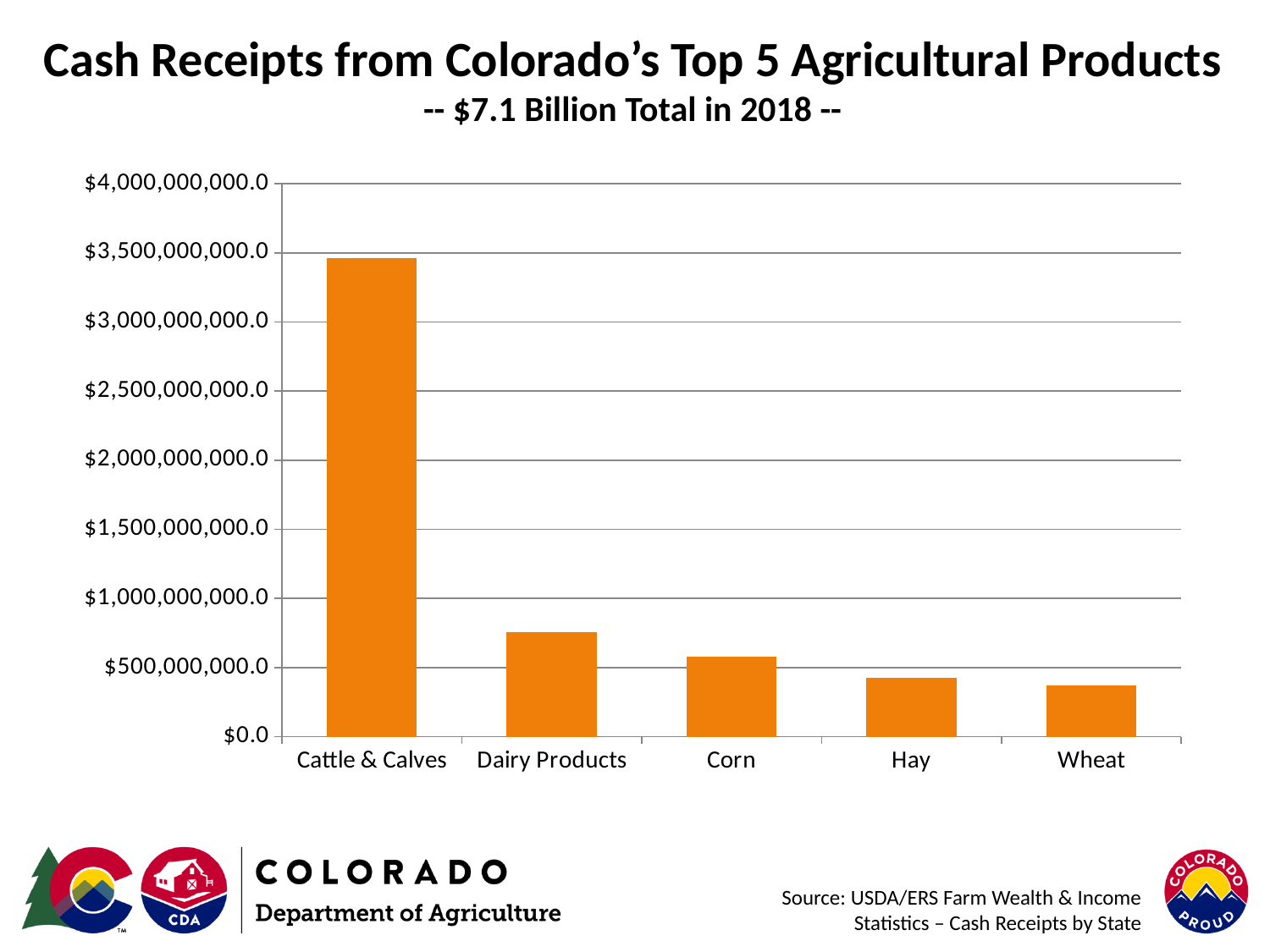
Which has higher cash receipts, Dairy Products or Corn? Dairy Products Is the value for Dairy Products greater or less than $500,000,000.0? greater Which product has the highest cash receipts? Cattle & Calves Do the values rise or fall moving from left to right across the categories? fall According to the subtitle, what was the total cash receipts from the top 5 products in 2018? $7.1 Billion How many agricultural products are shown on the chart? 5 Is the value for Hay greater or less than $500,000,000.0? less Is the value for Cattle & Calves greater or less than $3,000,000,000.0? greater Which product has the lowest cash receipts? Wheat What kind of chart is shown on the slide? bar chart